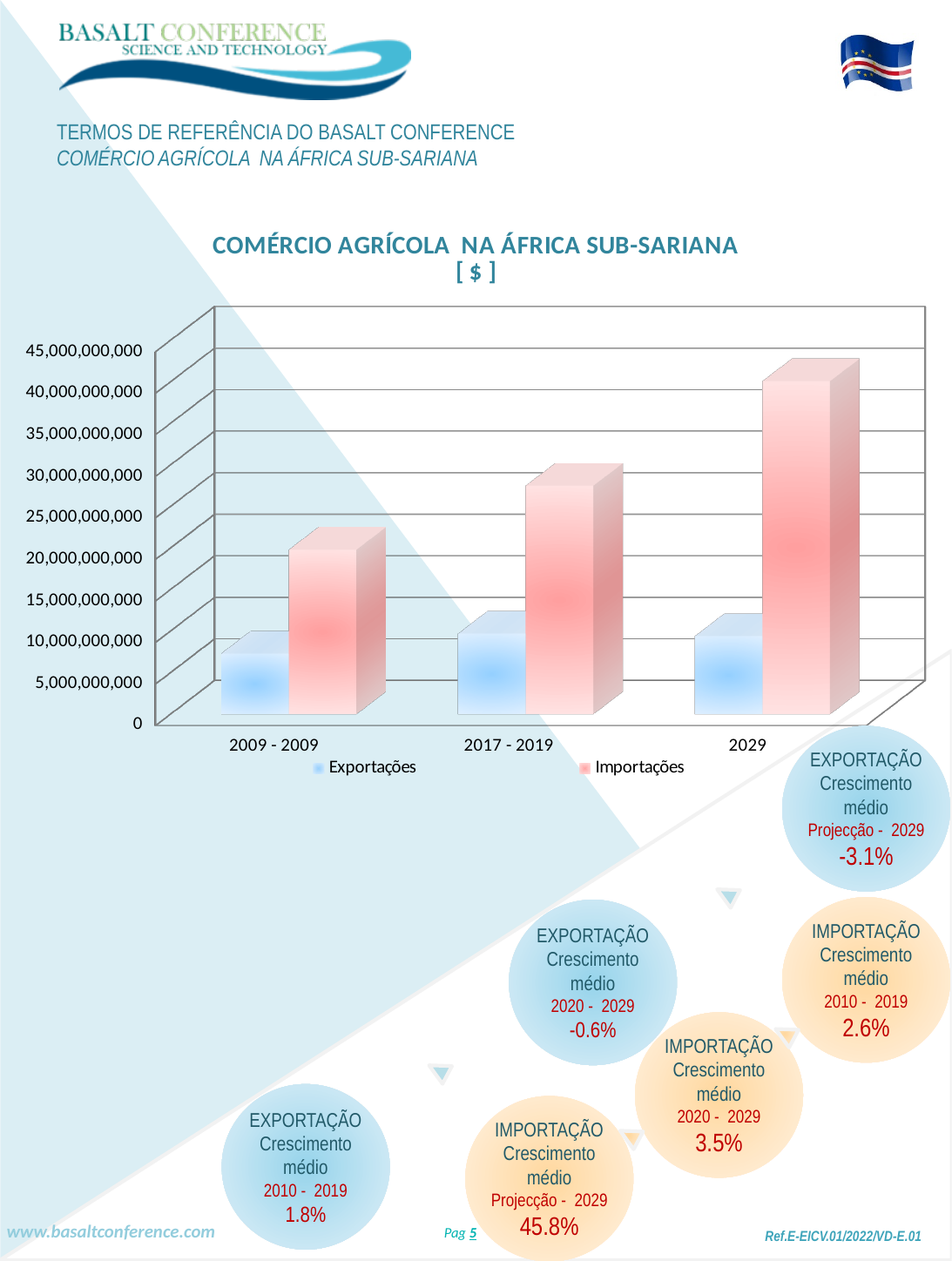
What are the two series named in the chart legend? Exportações and Importações Is the Importações value for 2009 - 2009 greater or less than 25,000,000,000? less What is the title of the chart? COMÉRCIO AGRÍCOLA NA ÁFRICA SUB-SARIANA [ $ ] Is the Exportações value for 2017 - 2019 greater or less than 15,000,000,000? less In which category is the Importações value lowest? 2009 - 2009 In which category is the Importações value highest? 2029 How many categories are shown on the x axis of the chart? 3 What kind of chart is shown on the slide? bar chart Do the Importações values rise or fall from left to right along the x axis? rise Is the Importações value for 2029 greater or less than 35,000,000,000? greater For 2029, which is larger: Exportações or Importações? Importações How many series does the chart legend list? 2